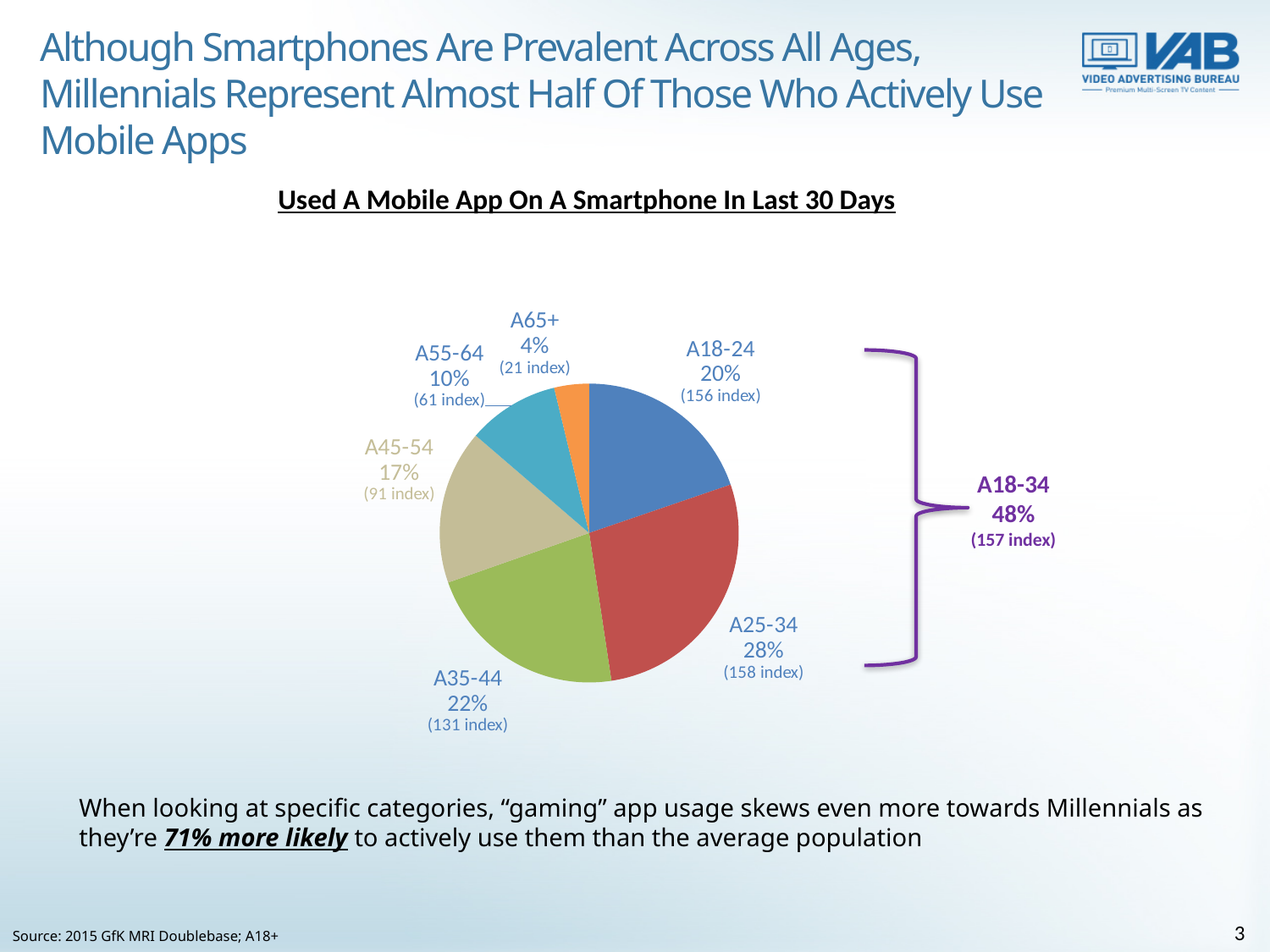
What is the title of the chart? Used A Mobile App On A Smartphone In Last 30 Days What share of the pie is the A45-54 slice? 17% Which slice is larger, A18-24 or A45-54? A18-24 How many age groups are shown in the pie chart? 6 What share of those who used a mobile app on a smartphone in the last 30 days are A25-34? 28% Which age group has the smallest slice of the pie? A65+ What index is shown for the A65+ group? 21 index Which age group has the largest slice of the pie? A25-34 What kind of chart is shown on the slide? Pie chart What is the difference in percentage points between the A35-44 and A55-64 slices? 12 What index is shown for the A18-24 group? 156 index What combined share is shown for the A18-34 group by the bracket? 48%